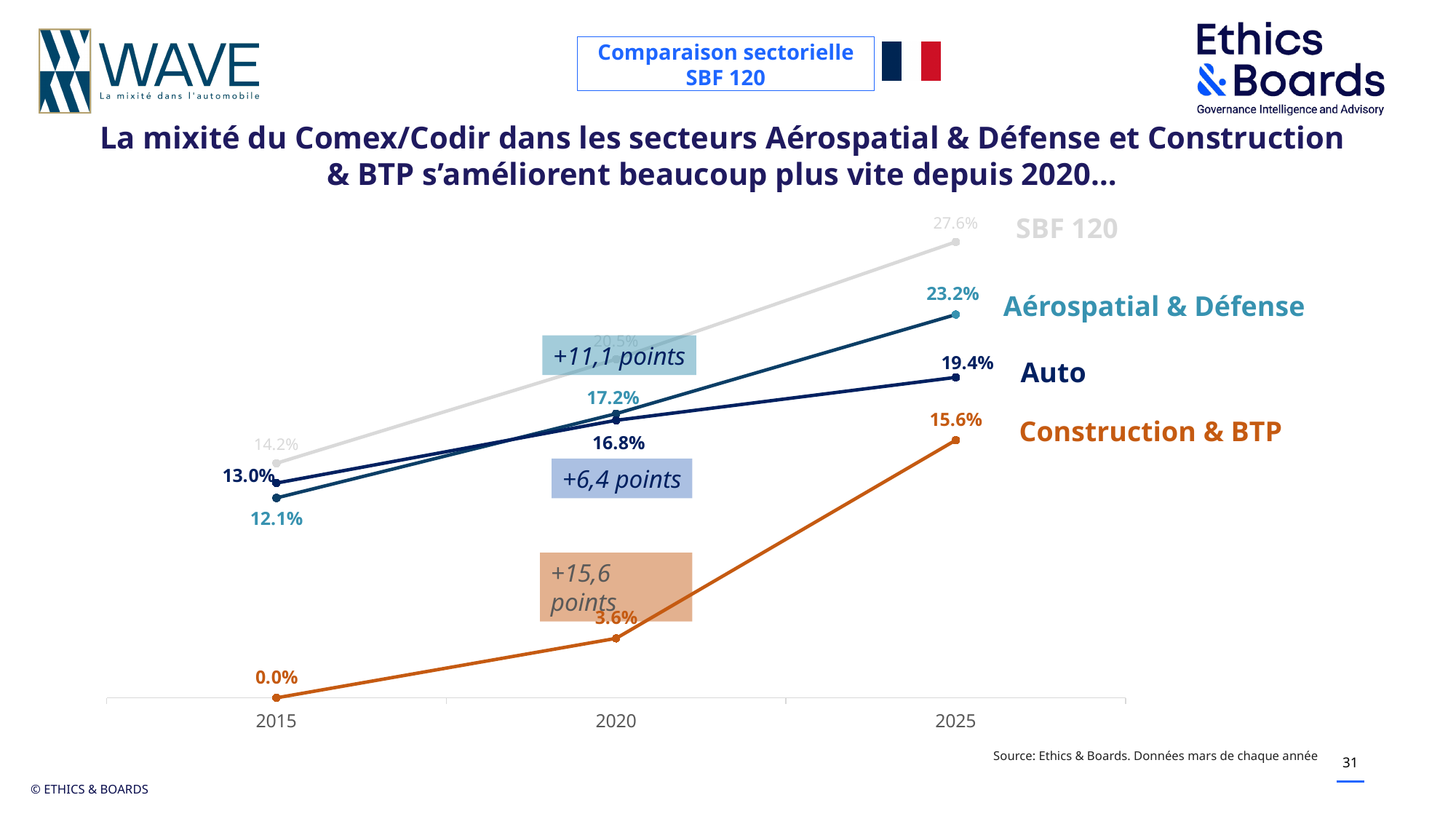
What is the difference between the Auto values in 2025 and 2015? 6.4 points Which series has the lowest value in 2020? Construction & BTP What is the value for SBF 120 in 2025? 27.6% Which is larger in 2015, the value for Auto or the value for Aérospatial & Défense? Auto Does the value for Construction & BTP rise or fall from 2015 to 2025? rise What is the value for Auto in 2020? 16.8% What is the value for Construction & BTP in 2015? 0.0% What type of chart is shown on the slide? line chart How many series are plotted on the chart? 4 Which series has the highest value in 2025? SBF 120 How many years are shown on the x axis? 3 What is the value for Aérospatial & Défense in 2025? 23.2%